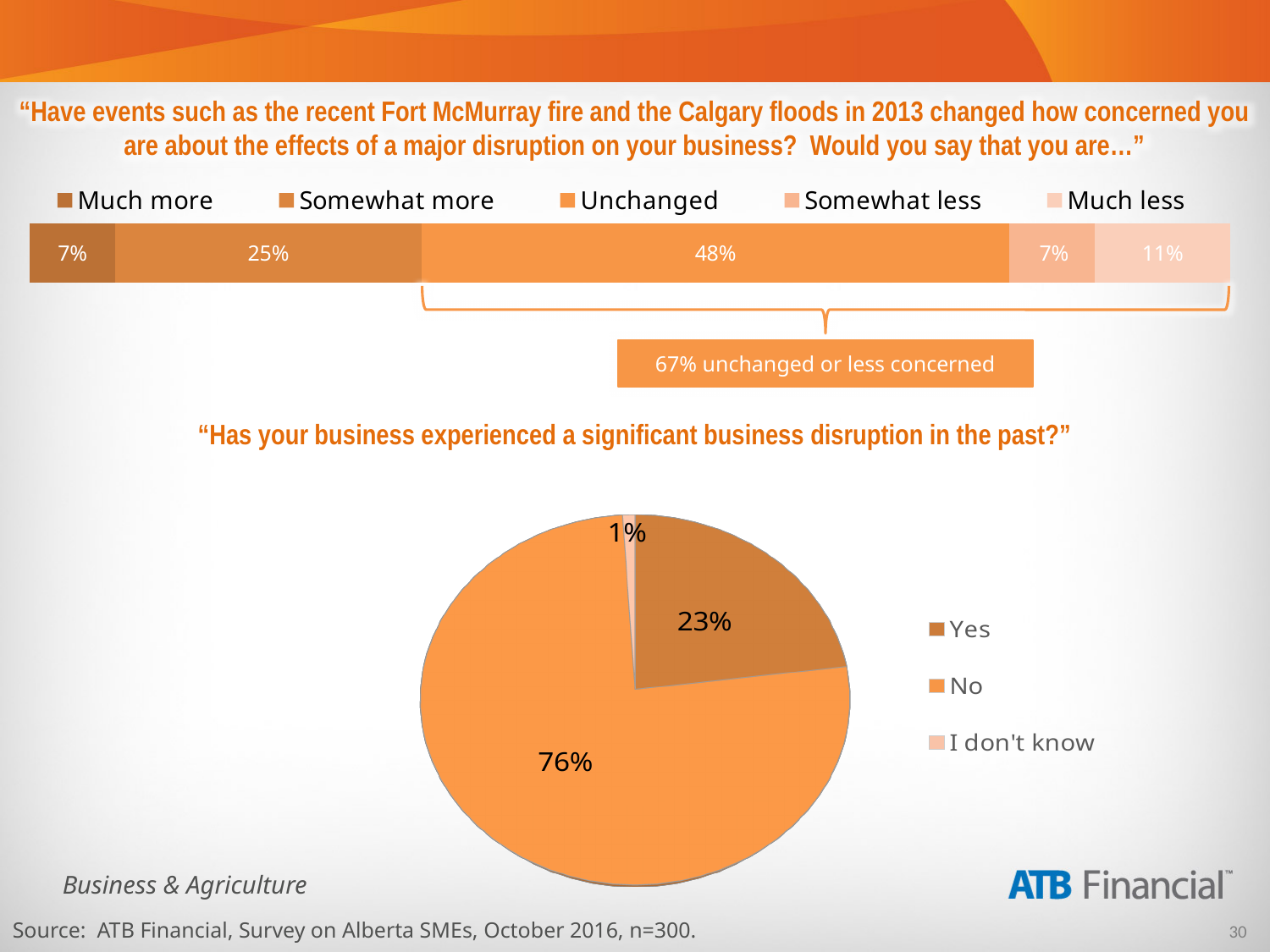
In the top stacked bar chart about changed concern, how many response categories does the legend list? 5 In the top stacked bar chart about changed concern, what percentage said 'Much less'? 11% In the top stacked bar chart about changed concern, which is larger: 'Somewhat more' or 'Much less'? Somewhat more In the bottom pie chart about past business disruption, what percentage answered 'No'? 76% In the top stacked bar chart about changed concern, what is the difference between the 'Unchanged' and 'Somewhat more' percentages? 23% In the top stacked bar chart about changed concern, which response has the largest share? Unchanged In the top stacked bar chart about changed concern, what percentage said 'Somewhat more'? 25% What type of chart is the bottom chart about past business disruption? Pie chart In the bottom pie chart about past business disruption, which response has the smallest slice? I don't know In the top stacked bar chart about changed concern, what percentage of respondents said 'Unchanged'? 48% In the top stacked bar chart about changed concern, what combined percentage does the bracket annotation say were unchanged or less concerned? 67% In the bottom pie chart about past business disruption, what percentage answered 'Yes'? 23%